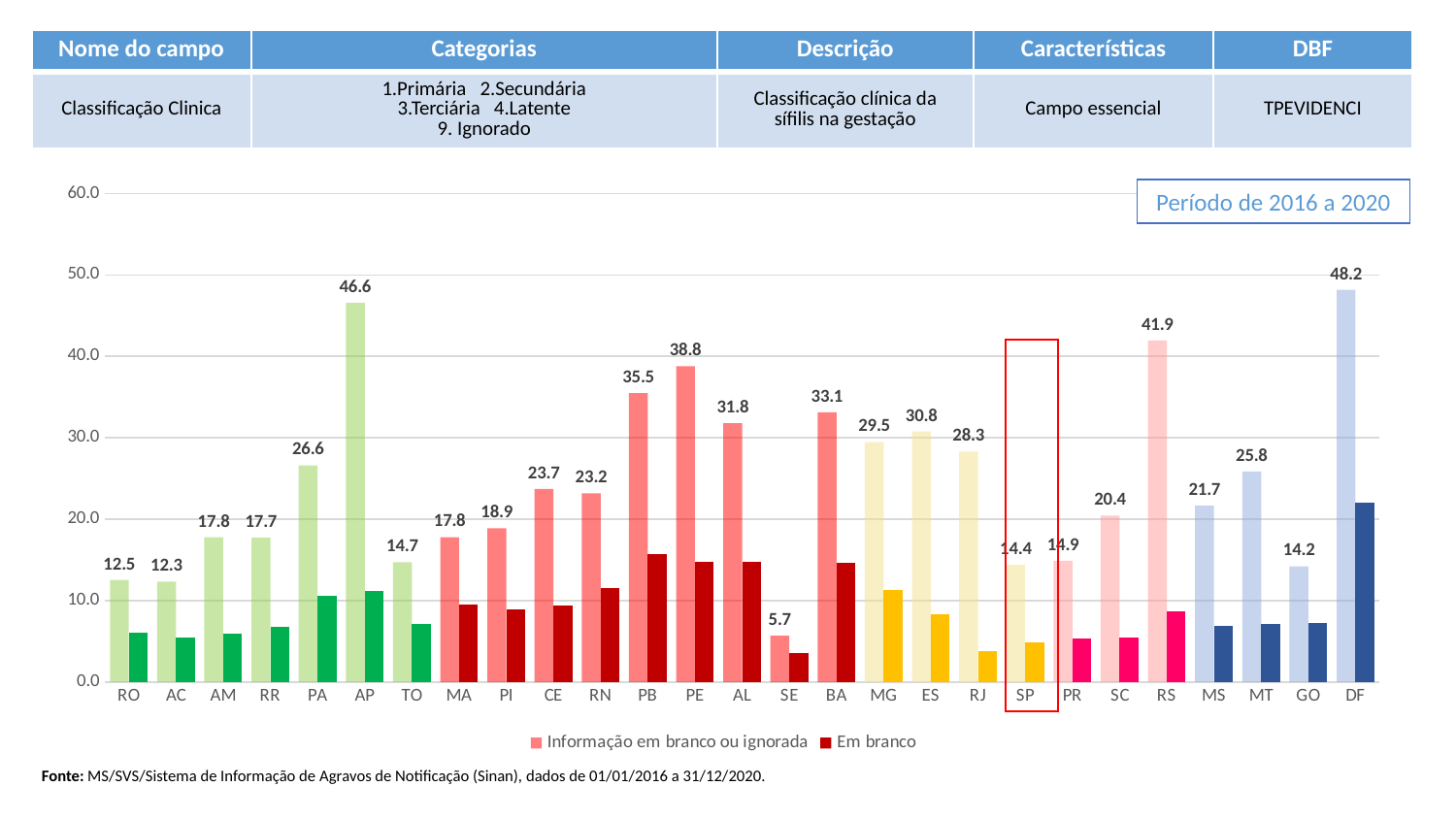
How many states are shown on the x axis of the chart? 27 What is the value of 'Informação em branco ou ignorada' for DF? 48.2 Is the 'Em branco' value for SE greater or less than 10.0? less What kind of chart is shown on the slide? Bar chart What is the difference between the 'Informação em branco ou ignorada' values for DF and AP? 1.6 What is the value of 'Informação em branco ou ignorada' for SP? 14.4 What is the value of 'Informação em branco ou ignorada' for AP? 46.6 How many series does the legend list? 2 Which state has the lowest value for 'Informação em branco ou ignorada'? SE Which state has the highest value for 'Informação em branco ou ignorada'? DF Is the 'Em branco' value for DF greater or less than 20.0? greater Which has a larger 'Informação em branco ou ignorada' value, PE or PB? PE